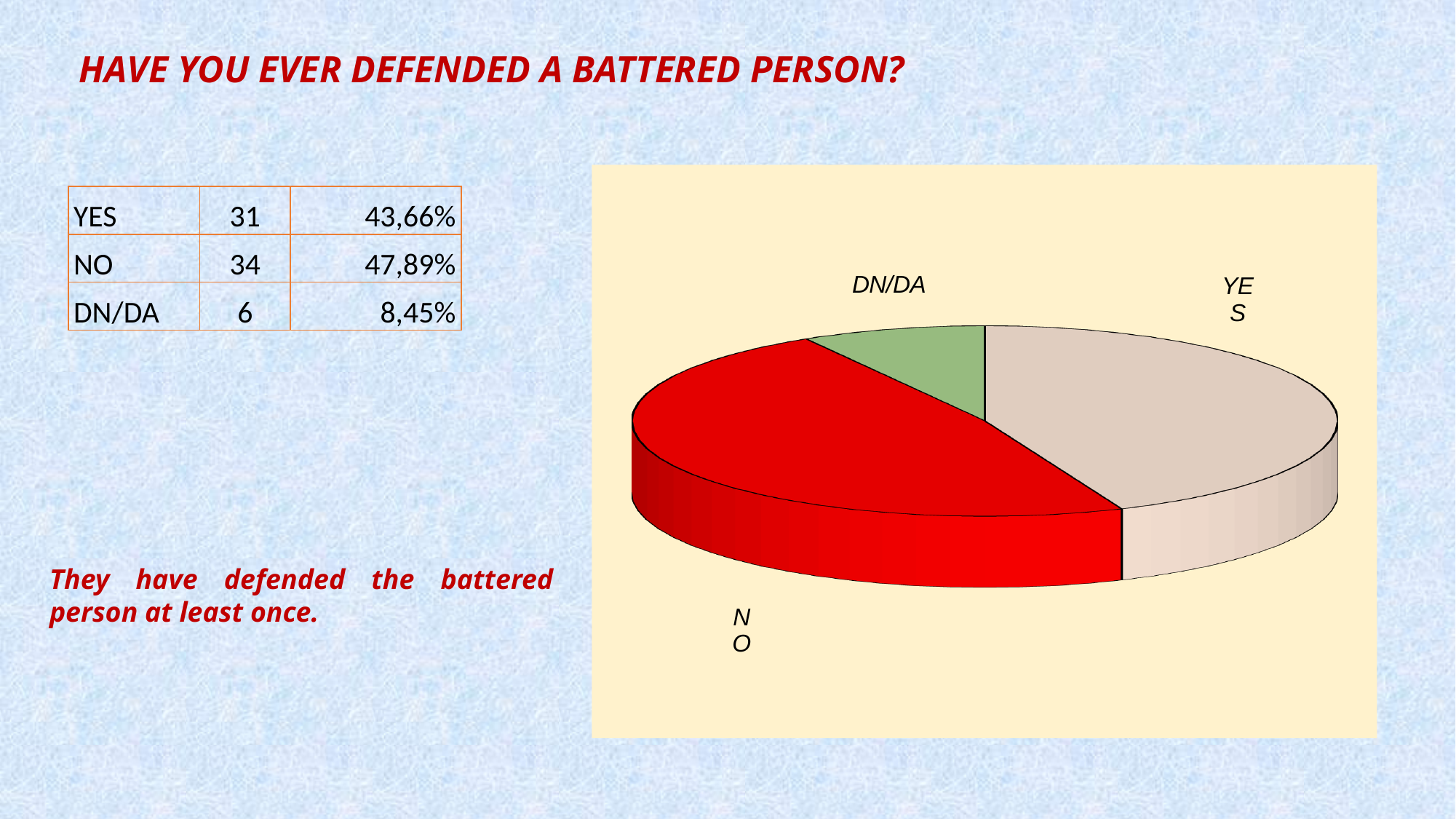
Which slice is larger, YES or DN/DA? YES How many slices does the pie chart have? 3 How many respondents answered DN/DA? 6 What percentage of respondents answered YES? 43,66% How many respondents answered YES? 31 How many more respondents answered NO than YES? 3 Which slice of the pie chart is the smallest? DN/DA What percentage of respondents answered DN/DA? 8,45% How many respondents answered NO? 34 What percentage of respondents answered NO? 47,89% Which slice of the pie chart is the largest? NO What kind of chart is shown on the slide? pie chart